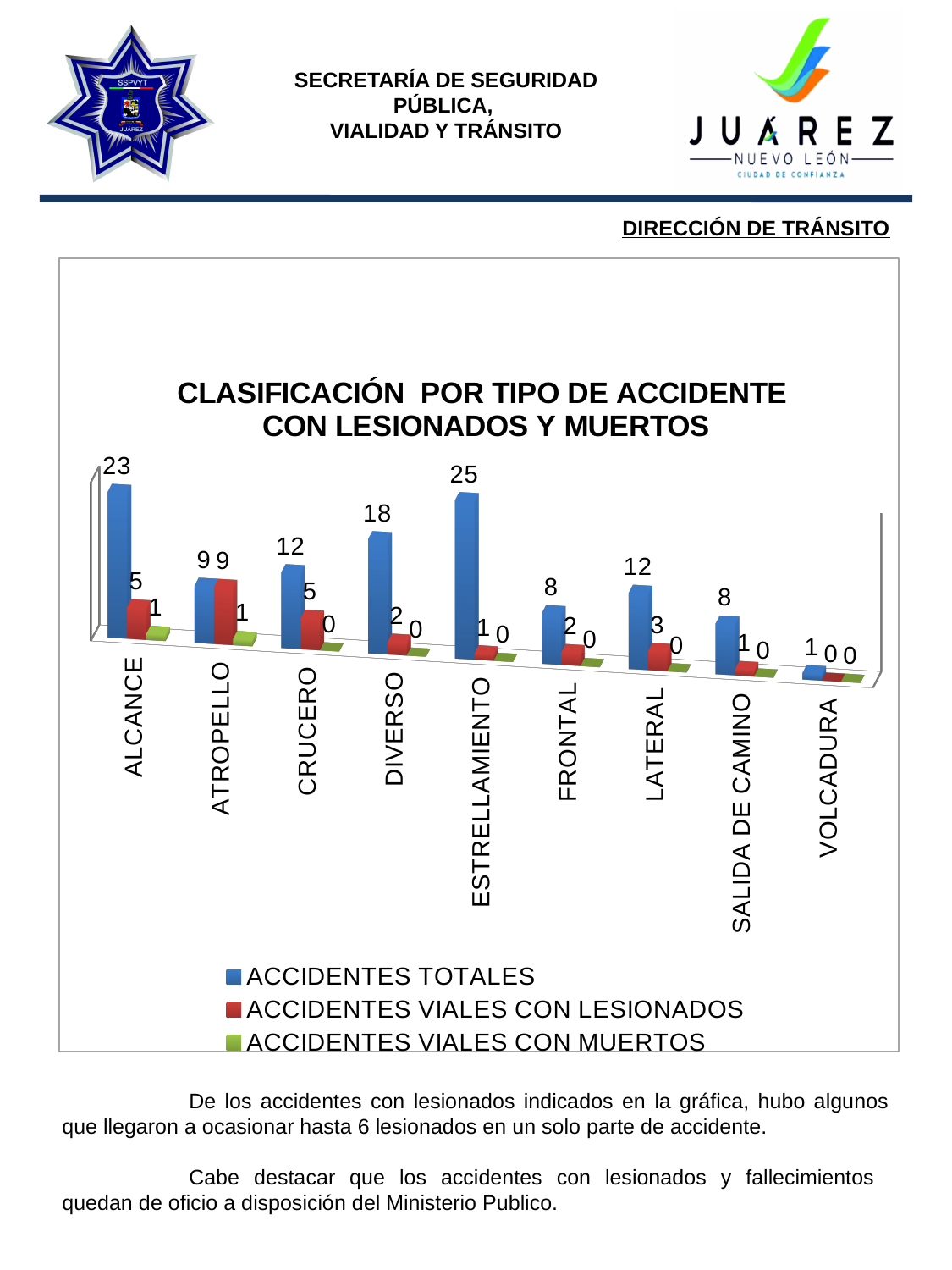
What kind of chart is shown on the slide? Bar chart Which category has the lowest value for ACCIDENTES TOTALES? VOLCADURA What is the difference between ACCIDENTES TOTALES and ACCIDENTES VIALES CON LESIONADOS for DIVERSO? 16 What is the value of ACCIDENTES TOTALES for ESTRELLAMIENTO? 25 What is the value of ACCIDENTES VIALES CON MUERTOS for ALCANCE? 1 Which category has the highest value for ACCIDENTES TOTALES? ESTRELLAMIENTO Which is larger, ACCIDENTES TOTALES for CRUCERO or for FRONTAL? CRUCERO How many accident type categories are shown on the x axis? 9 What is the value of ACCIDENTES VIALES CON LESIONADOS for ATROPELLO? 9 What is the difference between ACCIDENTES TOTALES for ESTRELLAMIENTO and for ALCANCE? 2 How many series does the legend list? 3 Which category has the highest value for ACCIDENTES VIALES CON LESIONADOS? ATROPELLO